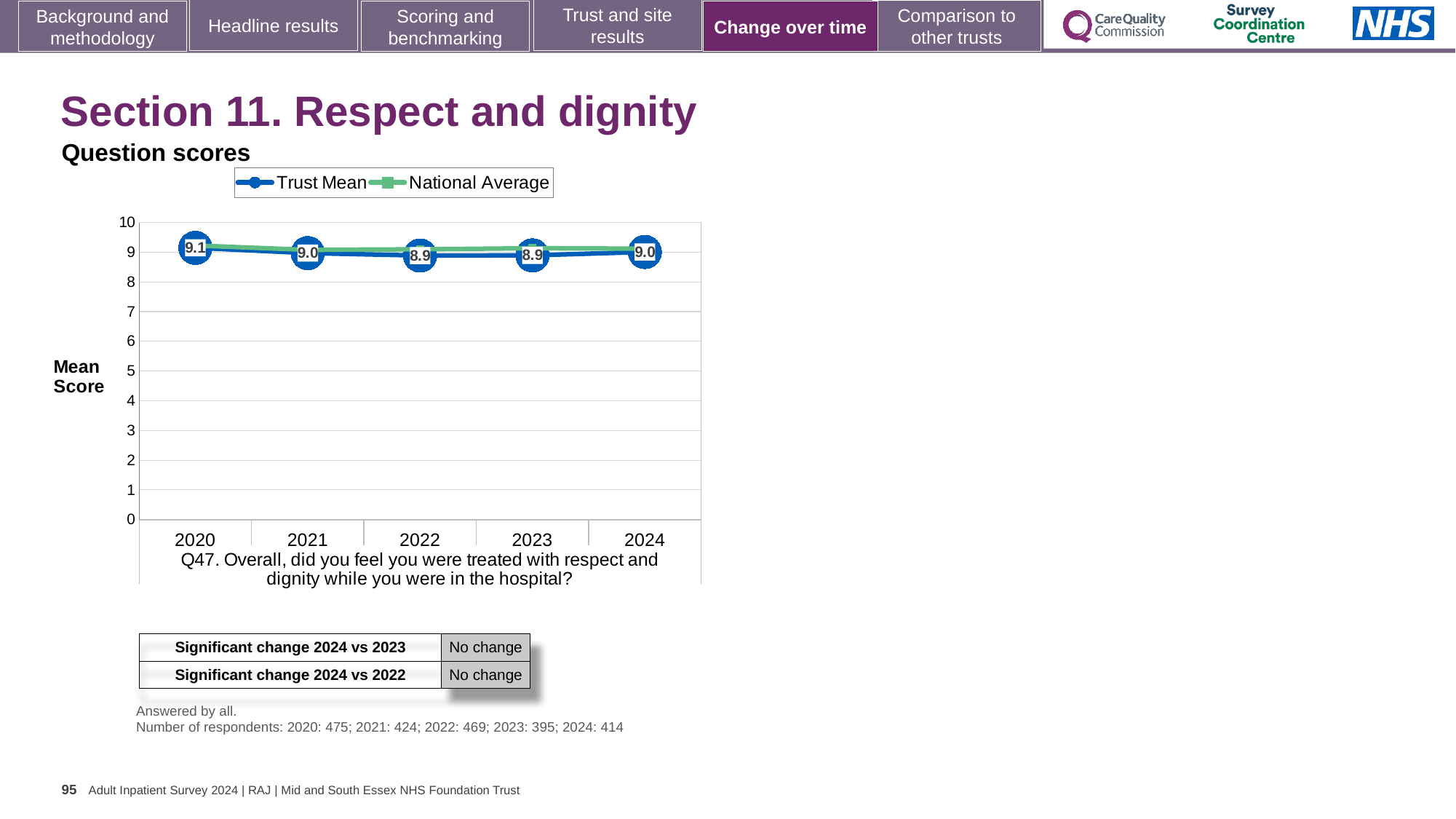
What is the Trust Mean score for 2024? 9.0 How many years are plotted on the x axis? 5 How many series does the legend list? 2 Which is larger, the Trust Mean score in 2020 or in 2023? 2020 What kind of chart is shown? Line chart In which year is the Trust Mean score highest? 2020 Is the National Average value for 2024 greater or less than 8? greater What is the Trust Mean score for 2020? 9.1 Does the Trust Mean score rise or fall from 2020 to 2022? Fall What is the Trust Mean score for 2022? 8.9 What is the label on the y axis of the chart? Mean Score What is the difference between the Trust Mean score in 2020 and in 2022? 0.2